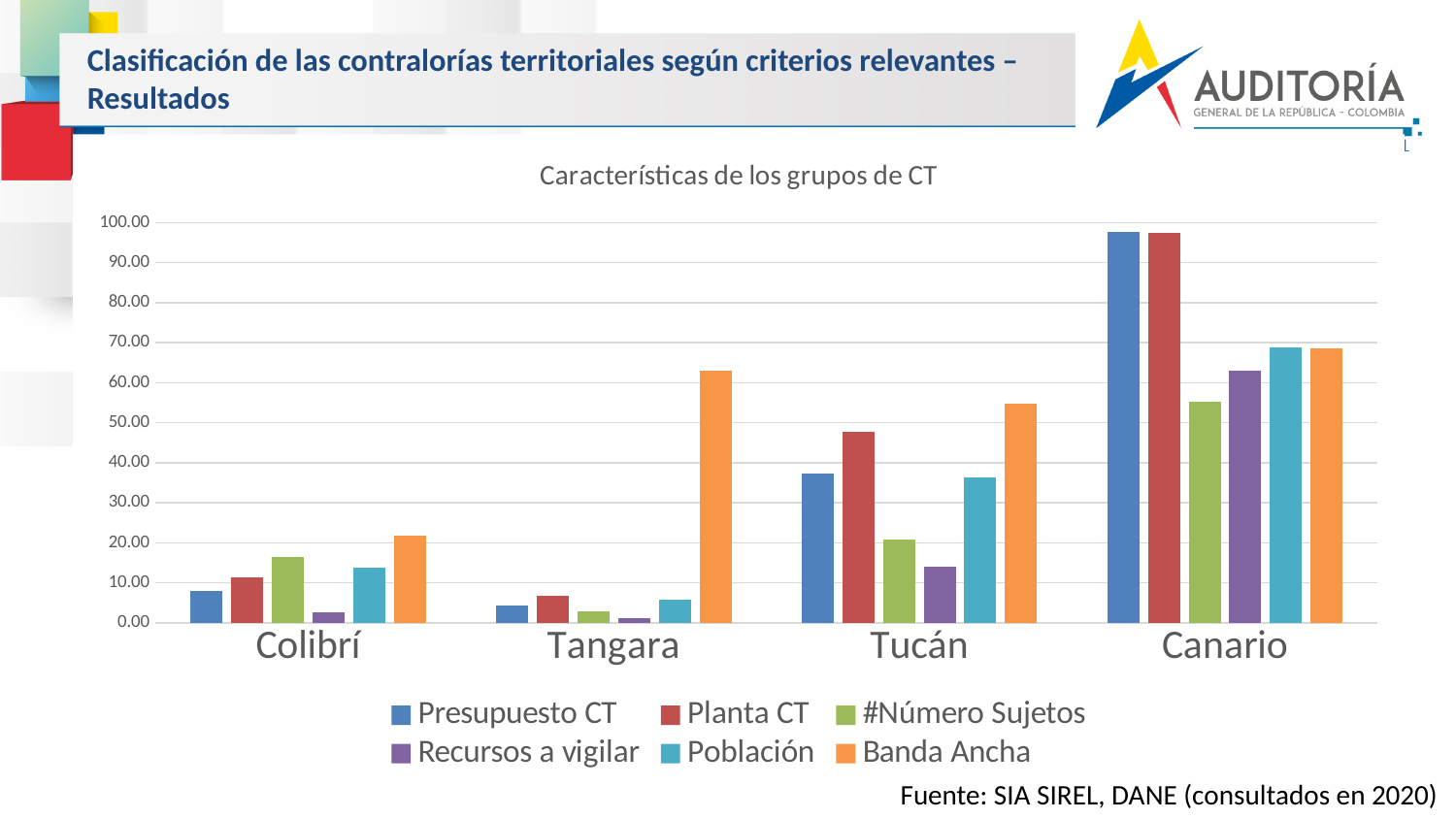
Is the value of Banda Ancha for Tangara greater or less than 50.00? greater Which category has the highest Presupuesto CT value? Canario How many categories are shown on the x axis? 4 What kind of chart is shown on the slide? bar chart Which is larger, the Banda Ancha value for Tucán or for Colibrí? Tucán How many series does the legend list? 6 Which category has the lowest Banda Ancha value? Colibrí Within Canario, which is larger, #Número Sujetos or Recursos a vigilar? Recursos a vigilar Is the value of Recursos a vigilar for Colibrí greater or less than 10.00? less Is the value of Presupuesto CT for Canario greater or less than 90.00? greater What is the title of the chart? Características de los grupos de CT